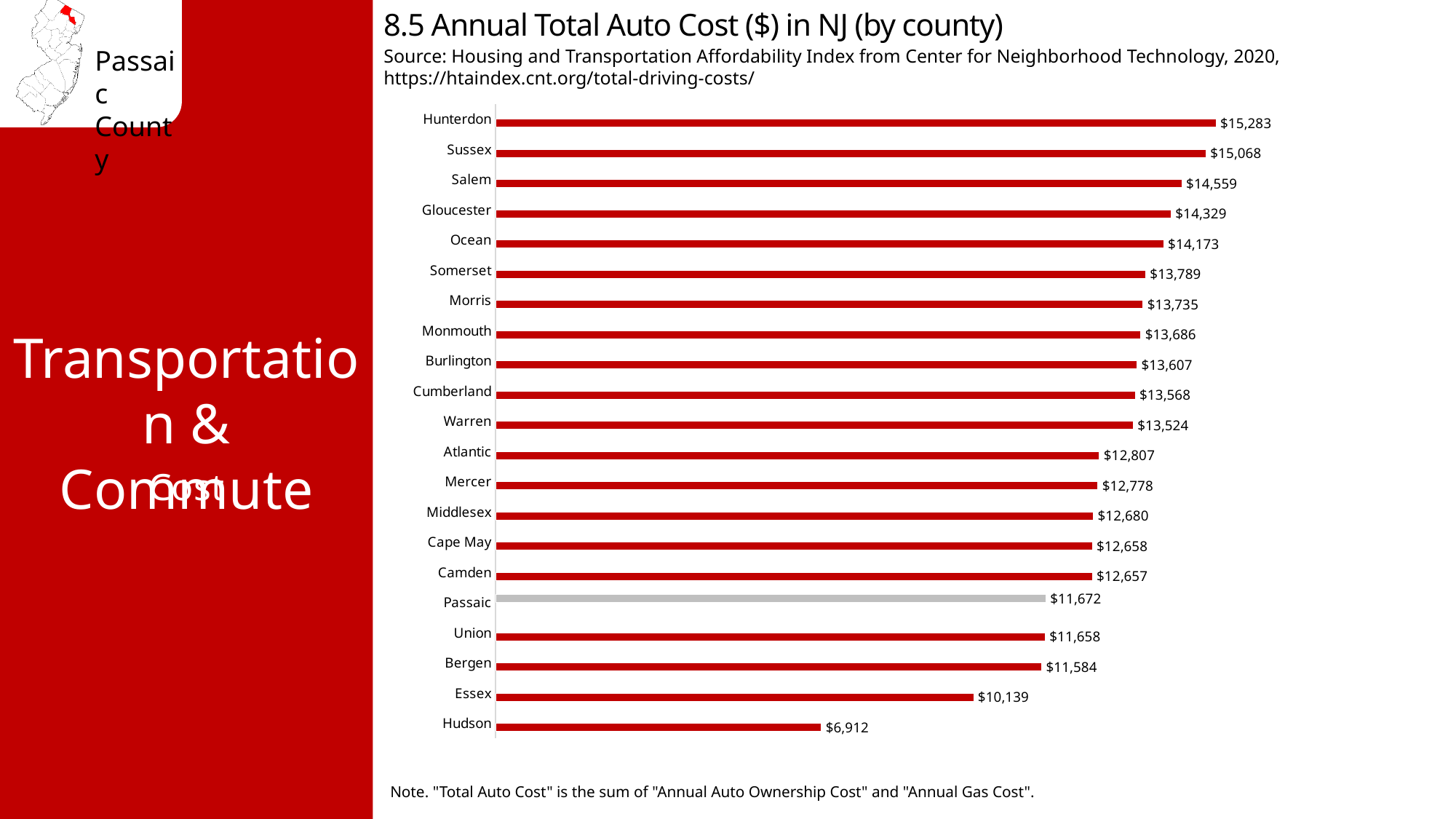
What is the difference in annual total auto cost between Passaic and Bergen counties? $88 Which county's bar is shown in gray instead of red? Passaic What type of chart is shown on the slide? Bar chart What is the annual total auto cost for Essex County? $10,139 Which county has the lowest annual total auto cost? Hudson Which county has the highest annual total auto cost? Hunterdon What is the annual total auto cost for Hunterdon County? $15,283 Which county has a higher annual total auto cost, Essex or Bergen? Bergen Which county has a higher annual total auto cost, Sussex or Salem? Sussex What is the difference in annual total auto cost between Hunterdon and Hudson counties? $8,371 What is the annual total auto cost for Passaic County? $11,672 How many counties are shown in the chart? 21